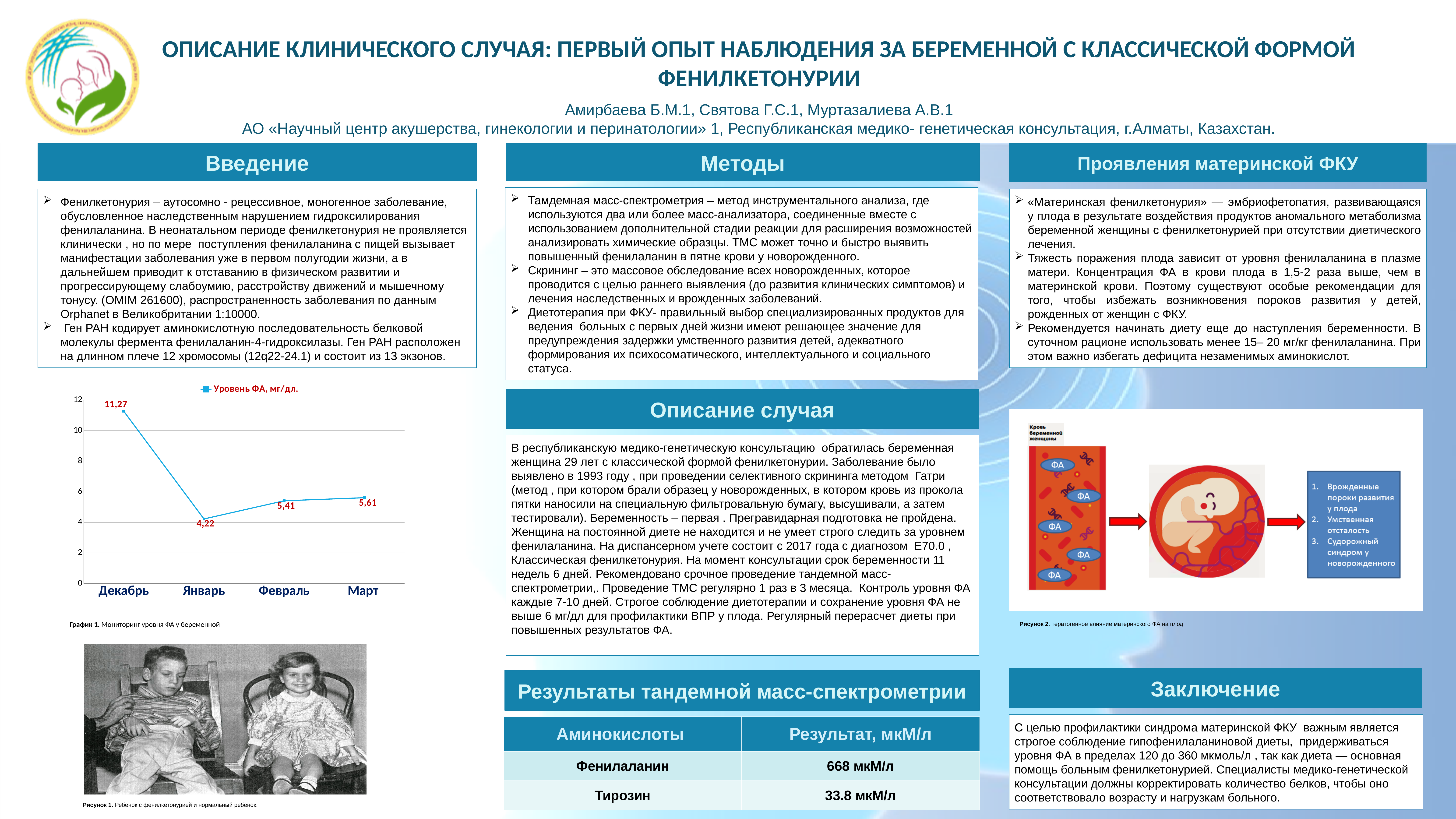
Which month has the highest value in the line chart? Декабрь What is the difference between the values for Декабрь and Январь in the line chart? 7,05 What is the legend entry of the line chart? Уровень ФА, мг/дл. What is the value for Март in the line chart? 5,61 Is the value for Декабрь in the line chart greater or less than 10? greater What is the value for Январь in the line chart? 4,22 Which is larger in the line chart, the value for Февраль or the value for Март? Март What is the value for Февраль in the line chart? 5,41 Which month has the lowest value in the line chart? Январь How many months are plotted on the x axis of the line chart? 4 What is the value for Декабрь in the line chart? 11,27 What kind of chart is shown on the left of the slide? line chart